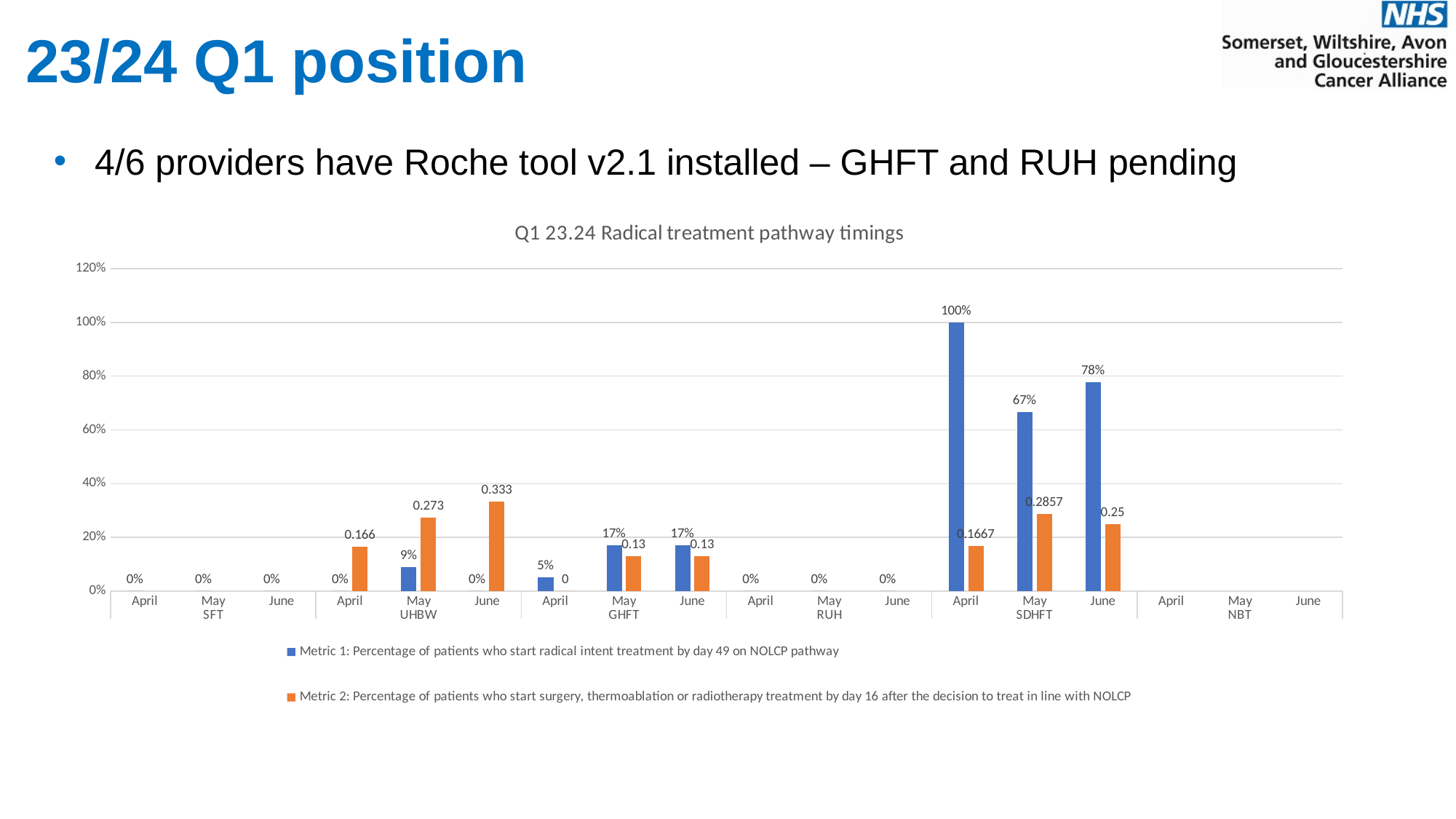
For SDHFT, is the Metric 1 value larger in May or in June? June What is the Metric 1 value for SDHFT in April? 100% What is the Metric 1 value for UHBW in May? 9% How many series does the legend list? 2 What is the Metric 2 value for SDHFT in May? 0.2857 What is the Metric 1 value for SDHFT in June? 78% How many providers are shown along the x axis of the chart? 6 What kind of chart is shown on the slide? bar chart Which provider and month has the highest Metric 1 value? SDHFT, April What is the Metric 2 value for UHBW in June? 0.333 What is the difference between the Metric 1 values for SDHFT in April and June? 22% What is the title of the chart? Q1 23.24 Radical treatment pathway timings